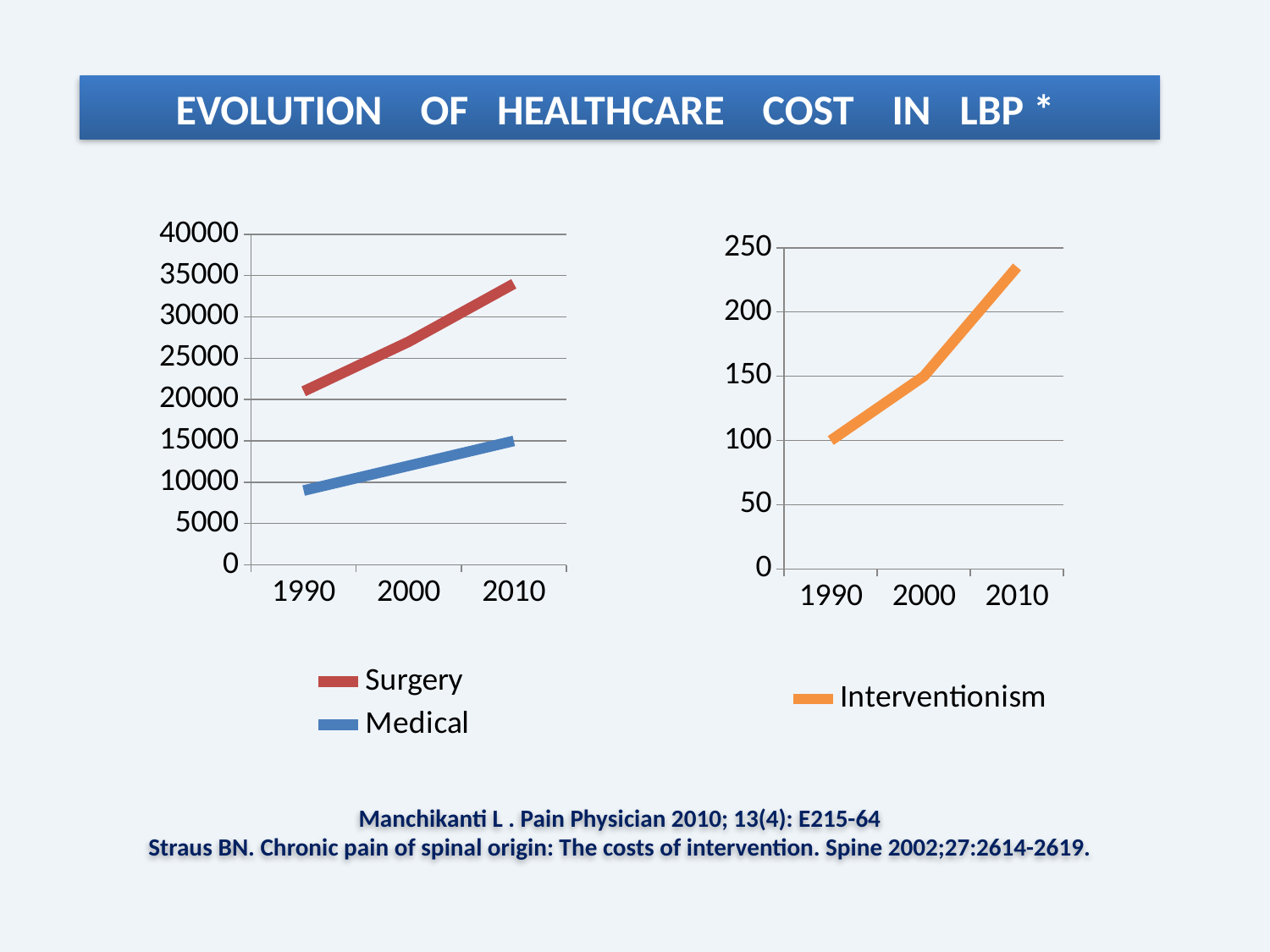
In the right chart, is the Interventionism value for 2010 greater or less than 200? greater In the left chart, is the Surgery value for 2010 greater or less than 30000? greater In the left chart, does the Surgery line rise or fall from 1990 to 2010? rise How many series does the legend of the left chart list? 2 What kind of chart is the right chart on the slide? line chart How many years are shown on the x axis of the left chart? 3 How many series does the legend of the right chart list? 1 In the right chart, does the Interventionism line rise or fall from 1990 to 2010? rise What kind of chart is the left chart on the slide? line chart In the left chart, which series has the higher value in 2010, Surgery or Medical? Surgery In the left chart, is the Medical value for 1990 greater or less than 10000? less What colour is the Interventionism line in the right chart? orange